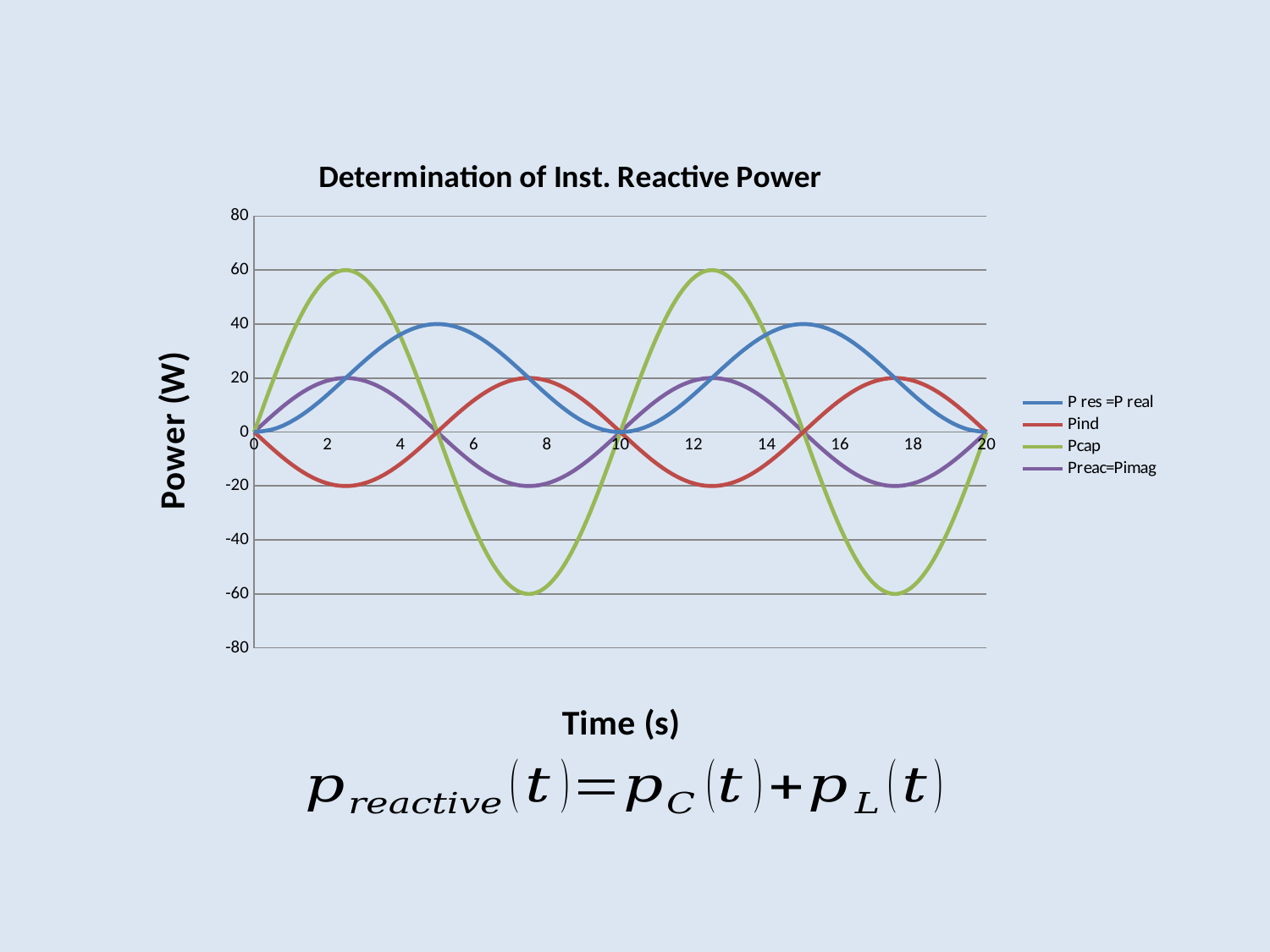
What is the title of the chart? Determination of Inst. Reactive Power Is the value of Pcap at time 2 greater or less than 40? greater Does the P res =P real series ever go below 0? No What is the label of the y axis? Power (W) What is the minimum value reached by the Pind series? -20 How many series does the legend list? 4 What type of chart is shown on the slide? line chart Which series reaches the highest peak value? Pcap Which series has a higher peak, P res =P real or Preac=Pimag? P res =P real What is the maximum value reached by the P res =P real series? 40 Which series reaches the lowest value on the chart? Pcap What is the maximum value reached by the Pcap series? 60